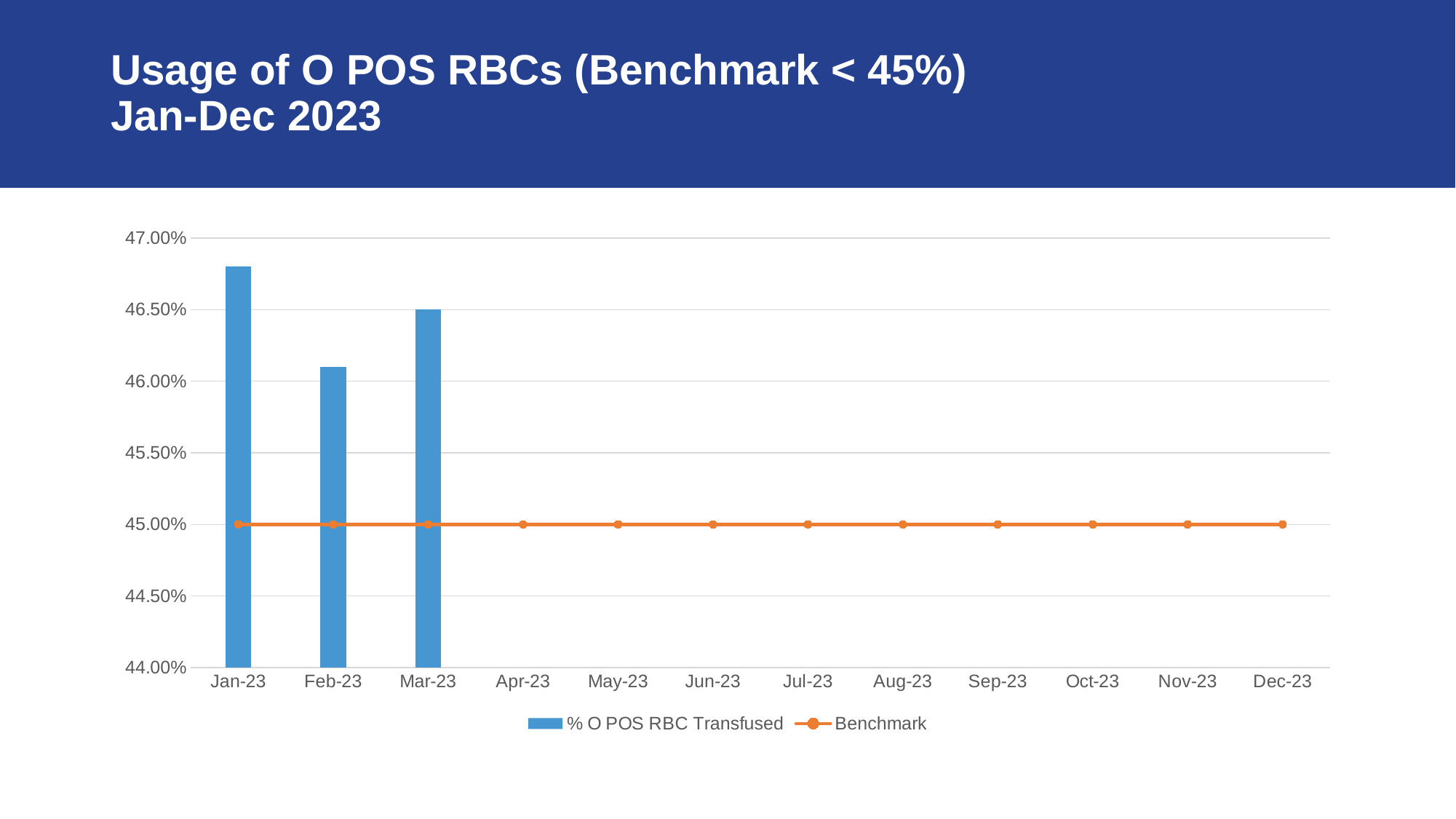
What is the % O POS RBC Transfused for Mar-23? 46.50% How many months have a bar plotted for % O POS RBC Transfused? 3 Which month has the highest % O POS RBC Transfused bar? Jan-23 Does the Benchmark line rise, fall, or stay flat across the months? stay flat What kind of chart is shown on the slide? bar chart with a line How many series does the legend list? 2 Which is larger, the % O POS RBC Transfused for Jan-23 or for Feb-23? Jan-23 Is the % O POS RBC Transfused for Jan-23 greater or less than 46.50%? greater Is the % O POS RBC Transfused for Feb-23 greater or less than 46.00%? greater How many months are shown on the x axis? 12 What is the Benchmark value for Jun-23? 45.00% Among the months with bars, which has the lowest % O POS RBC Transfused? Feb-23